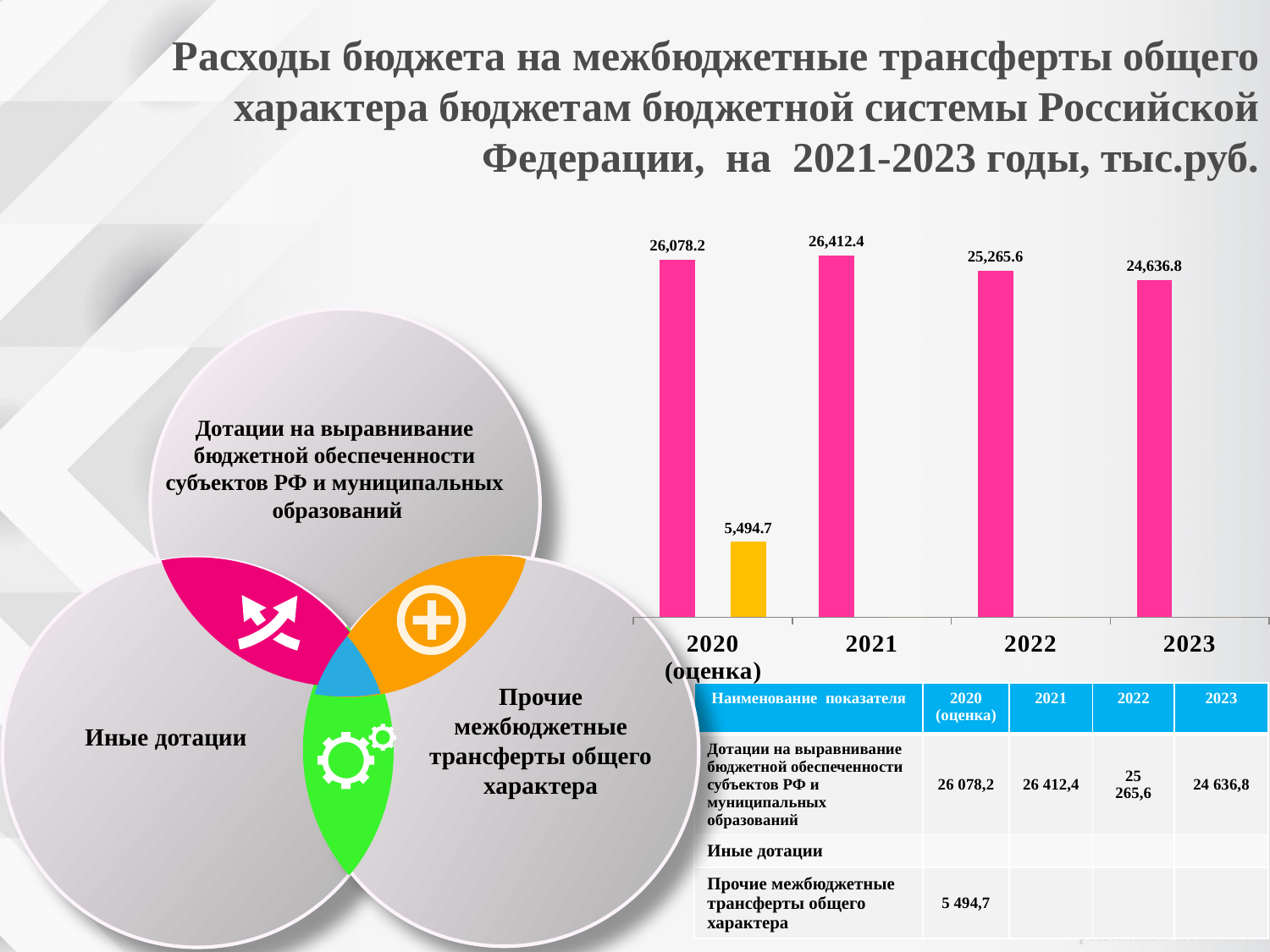
What is the value of the pink bar for 2021 in the bar chart? 26,412.4 What is the value of the pink bar for 2023 in the bar chart? 24,636.8 What is the value of the pink bar for 2020 (оценка) in the bar chart? 26,078.2 What is the difference between the pink bar and the yellow bar for 2020 (оценка)? 20,583.5 Do the pink bar values rise or fall from 2021 to 2023? fall In which year is the pink bar the highest? 2021 What is the value of the yellow bar for 2020 (оценка) in the bar chart? 5,494.7 How many year categories are shown on the x axis of the bar chart? 4 What is the value of the pink bar for 2022 in the bar chart? 25,265.6 Which year has the larger pink bar value, 2020 (оценка) or 2021? 2021 What is the difference between the pink bar values for 2021 and 2022? 1,146.8 In which year is the pink bar the lowest? 2023